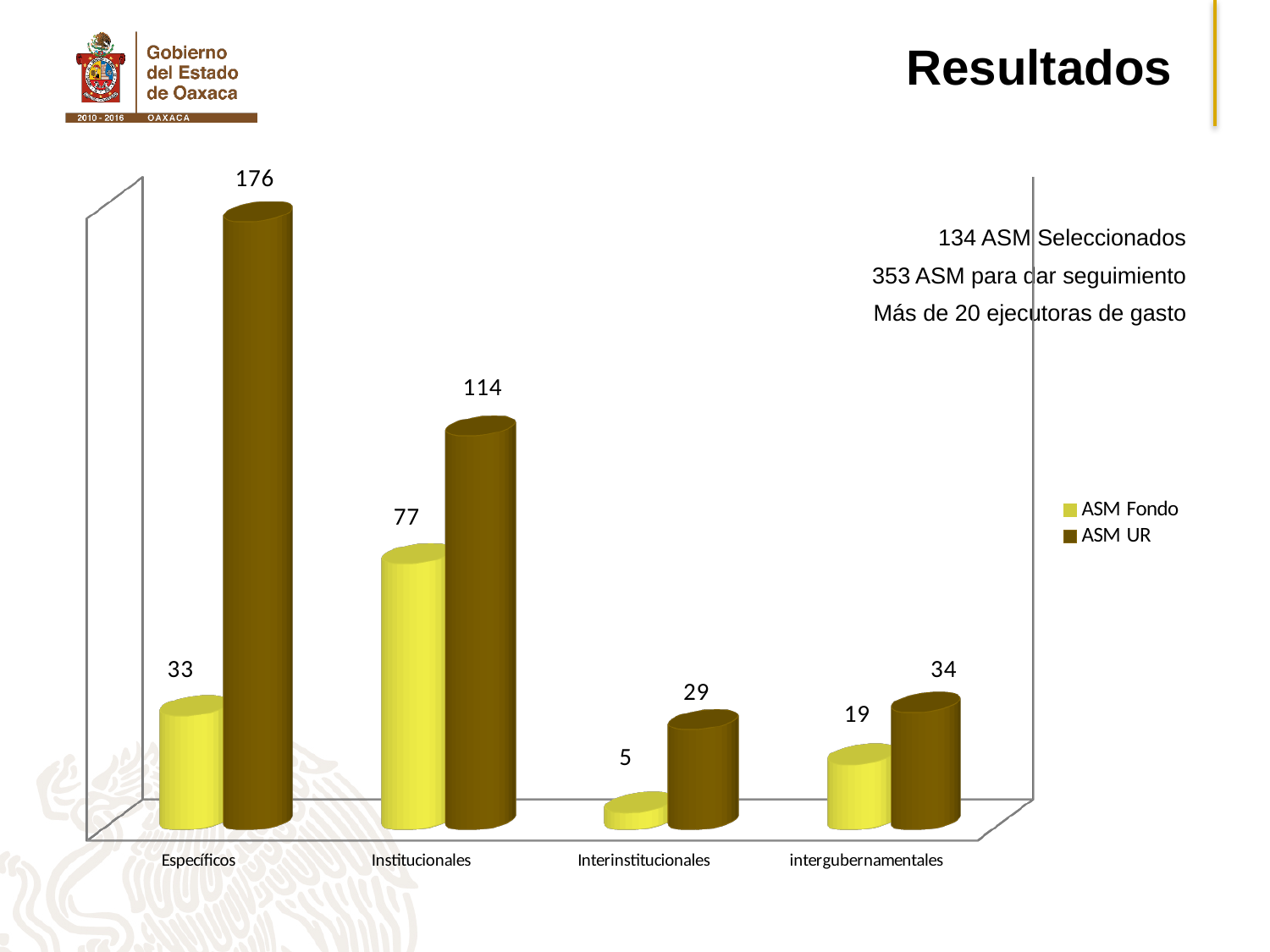
How many categories are shown on the x axis? 4 What kind of chart is shown on the slide? Bar chart What is the ASM UR value for Específicos? 176 Which series is shown in dark brown in the legend? ASM UR Which category has the highest ASM UR value? Específicos How many series does the legend list? 2 What is the difference between the ASM UR and ASM Fondo values for Específicos? 143 Which is larger for Institucionales, ASM Fondo or ASM UR? ASM UR What is the ASM Fondo value for Institucionales? 77 What is the ASM Fondo value for Interinstitucionales? 5 Which category has the lowest ASM Fondo value? Interinstitucionales What is the ASM UR value for intergubernamentales? 34